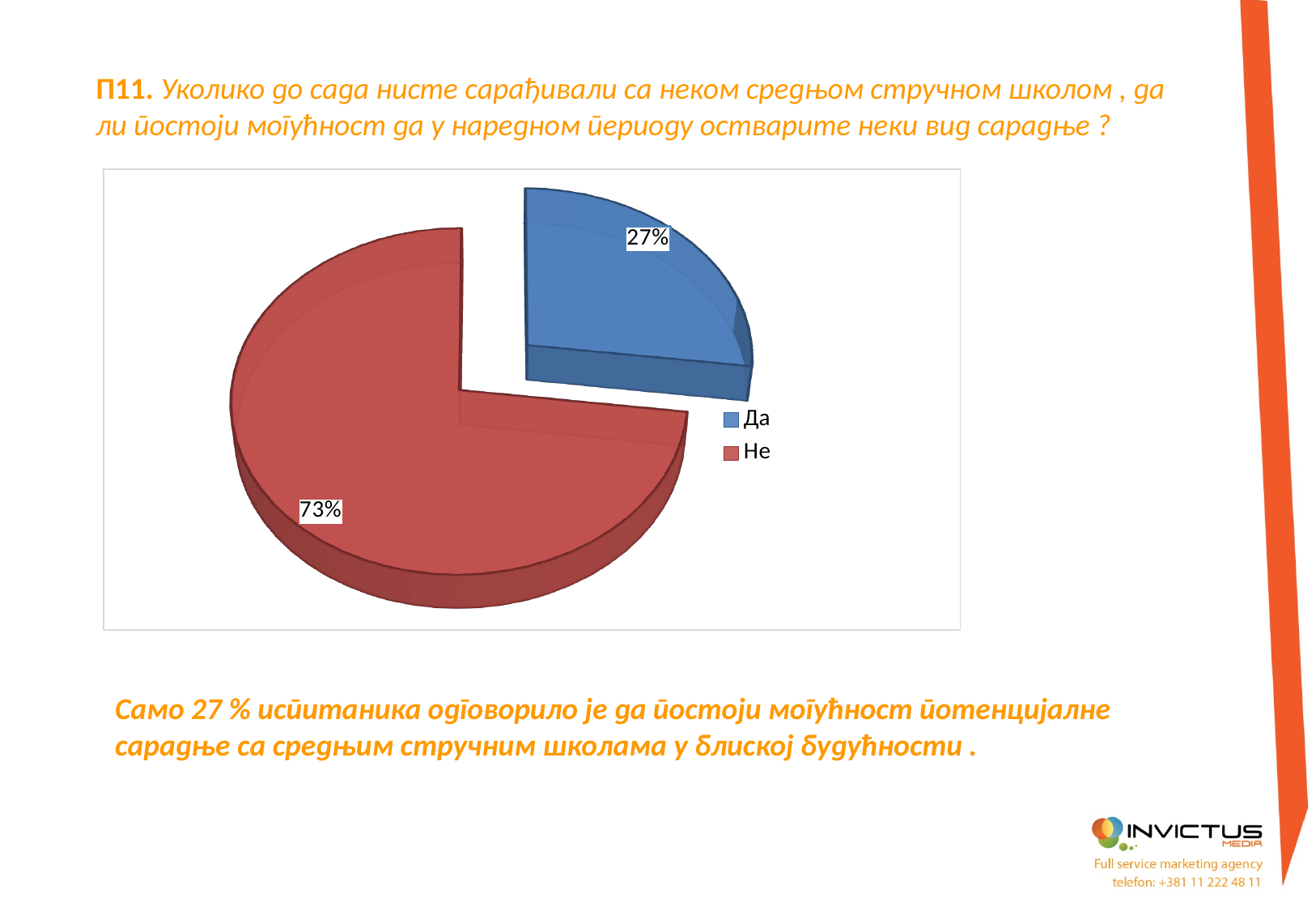
Which category has the smallest slice of the pie? Да How many categories does the pie chart show? 2 What colour is the "Да" slice? blue What colour is the "Не" slice? red Which slice is larger, "Да" or "Не"? Не What is the difference in percentage points between the "Не" and "Да" slices? 46 How many entries does the legend list? 2 Which category has the largest slice of the pie? Не What share of the pie does the "Да" slice represent? 27% What kind of chart is shown on the slide? pie chart What share of the pie does the "Не" slice represent? 73%